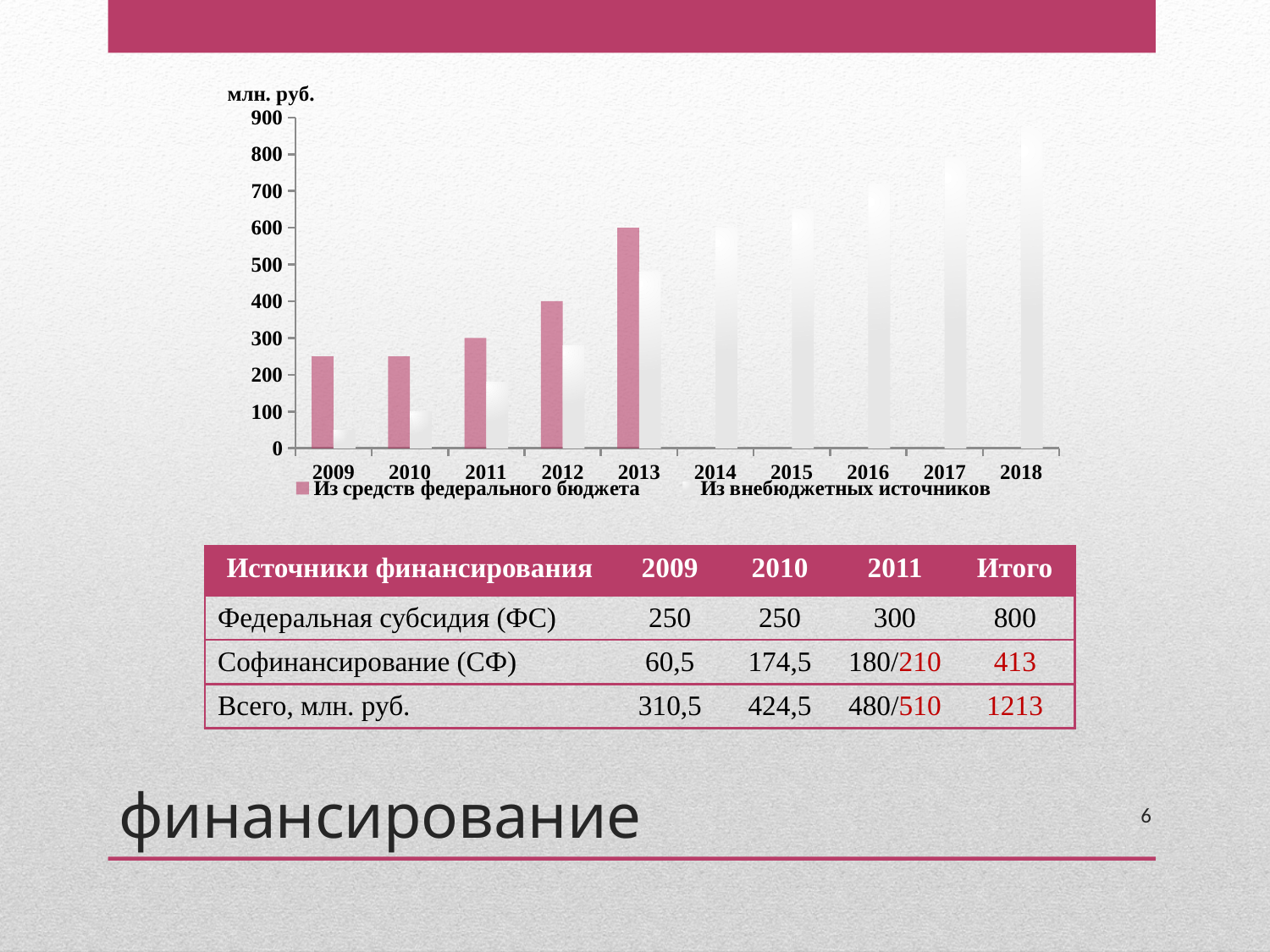
What kind of chart is shown on the slide? bar chart Is the value for 'Из внебюджетных источников' in 2018 greater or less than 700? greater How many years are shown along the x axis of the chart? 10 How many series does the chart legend list? 2 Is the value for 'Из средств федерального бюджета' in 2009 greater or less than 200? greater In which year is the 'Из средств федерального бюджета' bar the highest? 2013 What is the value for 'Из средств федерального бюджета' in 2012? 400 What is the value for 'Из средств федерального бюджета' in 2011? 300 What is the value for 'Из средств федерального бюджета' in 2013? 600 In 2013, which series has the larger value: 'Из средств федерального бюджета' or 'Из внебюджетных источников'? Из средств федерального бюджета What is the difference between the 'Из средств федерального бюджета' values for 2013 and 2012? 200 Do the 'Из внебюджетных источников' values rise or fall from 2009 to 2018? rise